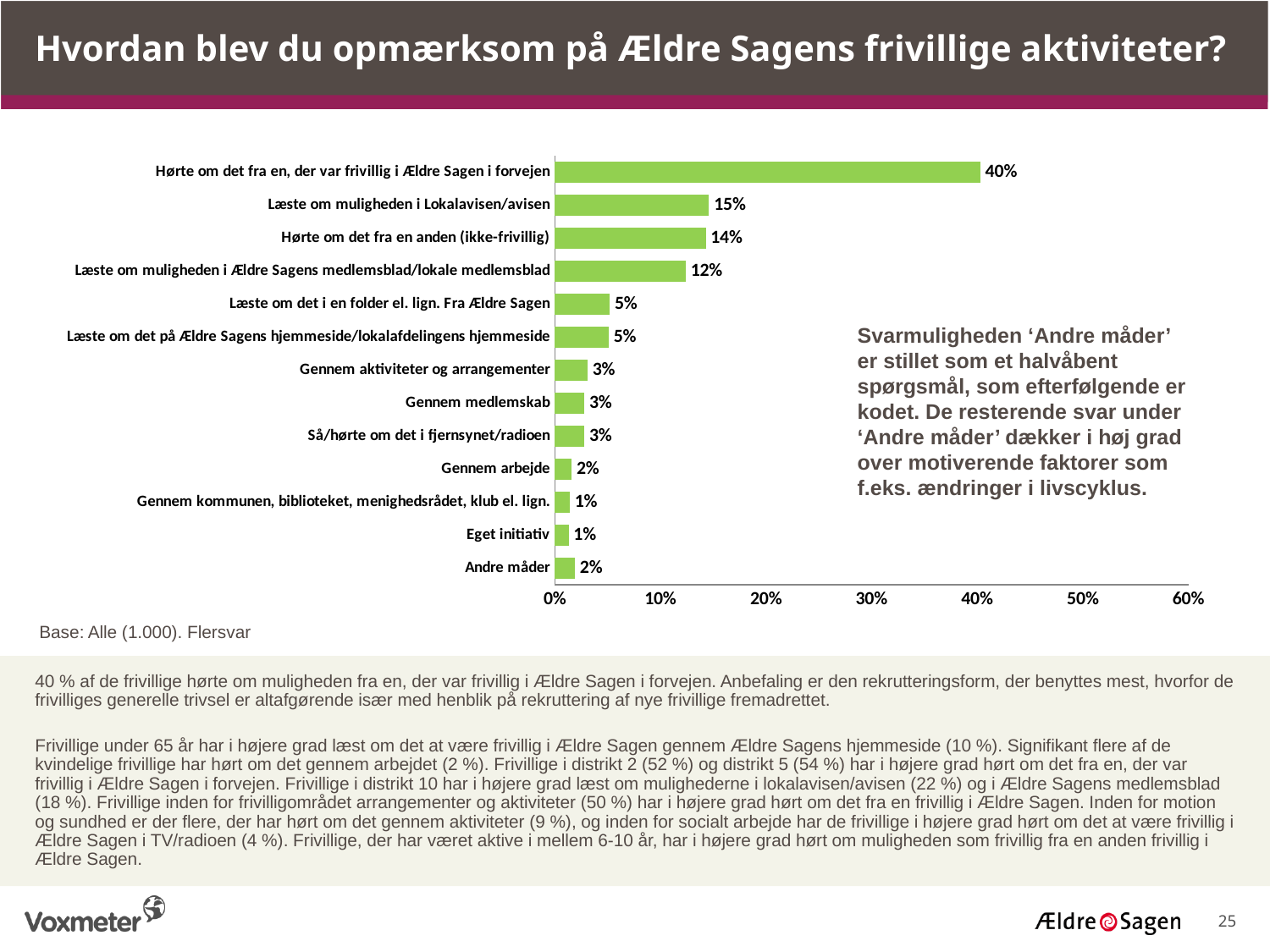
How many categories are shown in the chart? 13 What is the value for 'Gennem arbejde'? 2% What is the difference between 'Læste om muligheden i Ældre Sagens medlemsblad/lokale medlemsblad' and 'Læste om det i en folder el. lign. Fra Ældre Sagen'? 7% What kind of chart is shown on the slide? Bar chart What is the value for 'Hørte om det fra en anden (ikke-frivillig)'? 14% Which category has the highest value? Hørte om det fra en, der var frivillig i Ældre Sagen i forvejen What is the value for 'Læste om muligheden i Lokalavisen/avisen'? 15% What is the difference between 'Hørte om det fra en, der var frivillig i Ældre Sagen i forvejen' and 'Læste om muligheden i Lokalavisen/avisen'? 25% What is the highest value shown on the x axis? 60% What is the value for 'Hørte om det fra en, der var frivillig i Ældre Sagen i forvejen'? 40% What is the value for 'Eget initiativ'? 1% Which is larger: 'Læste om muligheden i Lokalavisen/avisen' or 'Læste om muligheden i Ældre Sagens medlemsblad/lokale medlemsblad'? Læste om muligheden i Lokalavisen/avisen